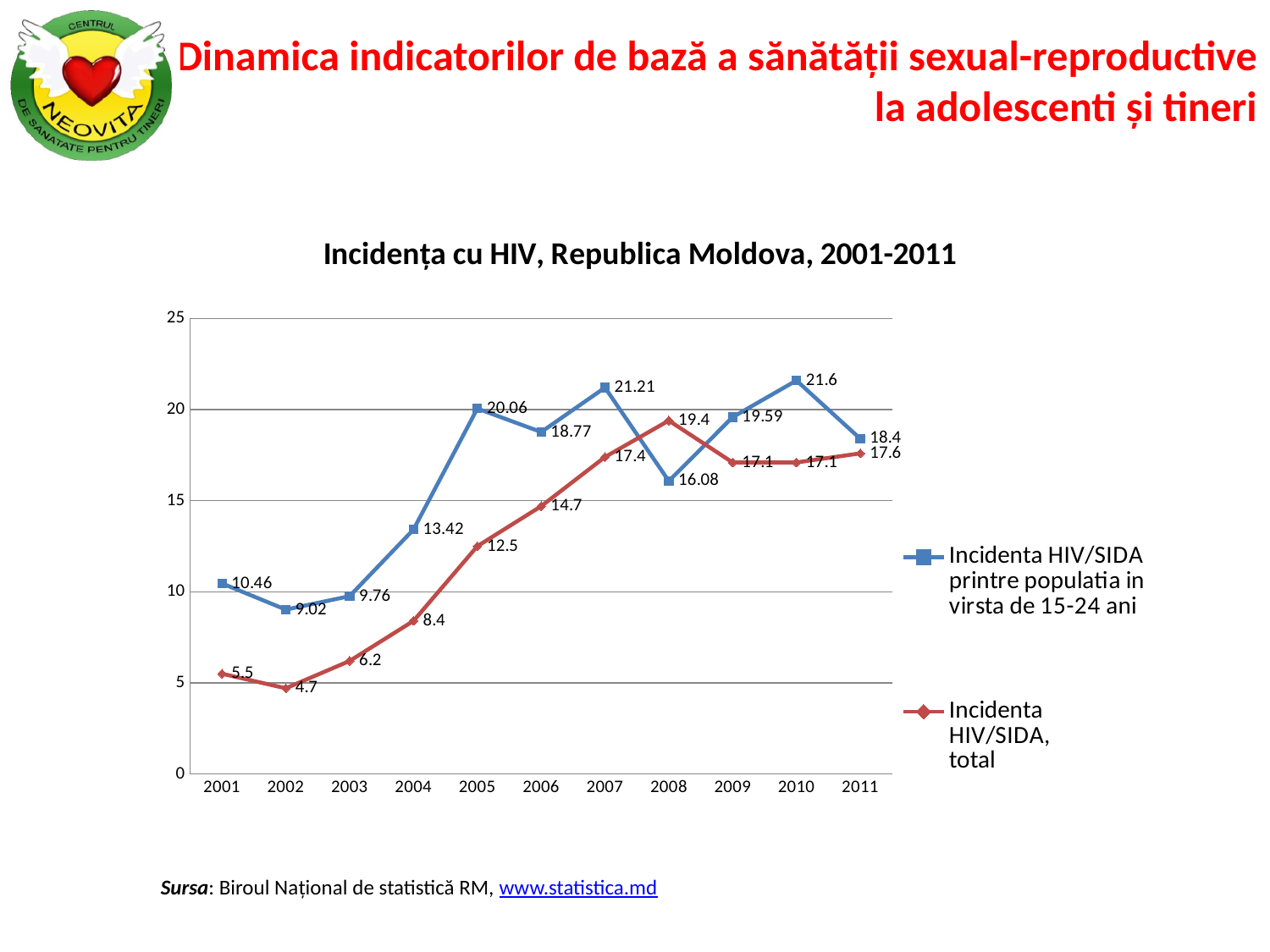
What is the value for 'Incidenta HIV/SIDA, total' in 2008? 19.4 In which year is 'Incidenta HIV/SIDA printre populatia in virsta de 15-24 ani' highest? 2010 What kind of chart is shown? line chart Is the value for 'Incidenta HIV/SIDA, total' in 2006 greater or less than 15? less What is the title of the chart? Incidența cu HIV, Republica Moldova, 2001-2011 How many series does the legend list? 2 Which series has the larger value in 2008? Incidenta HIV/SIDA, total In which year is 'Incidenta HIV/SIDA, total' lowest? 2002 How many years are shown on the x axis? 11 What is the difference between the 15-24 ani series and the total series in 2004? 5.02 What is the value for 'Incidenta HIV/SIDA, total' in 2001? 5.5 What is the value for 'Incidenta HIV/SIDA printre populatia in virsta de 15-24 ani' in 2005? 20.06